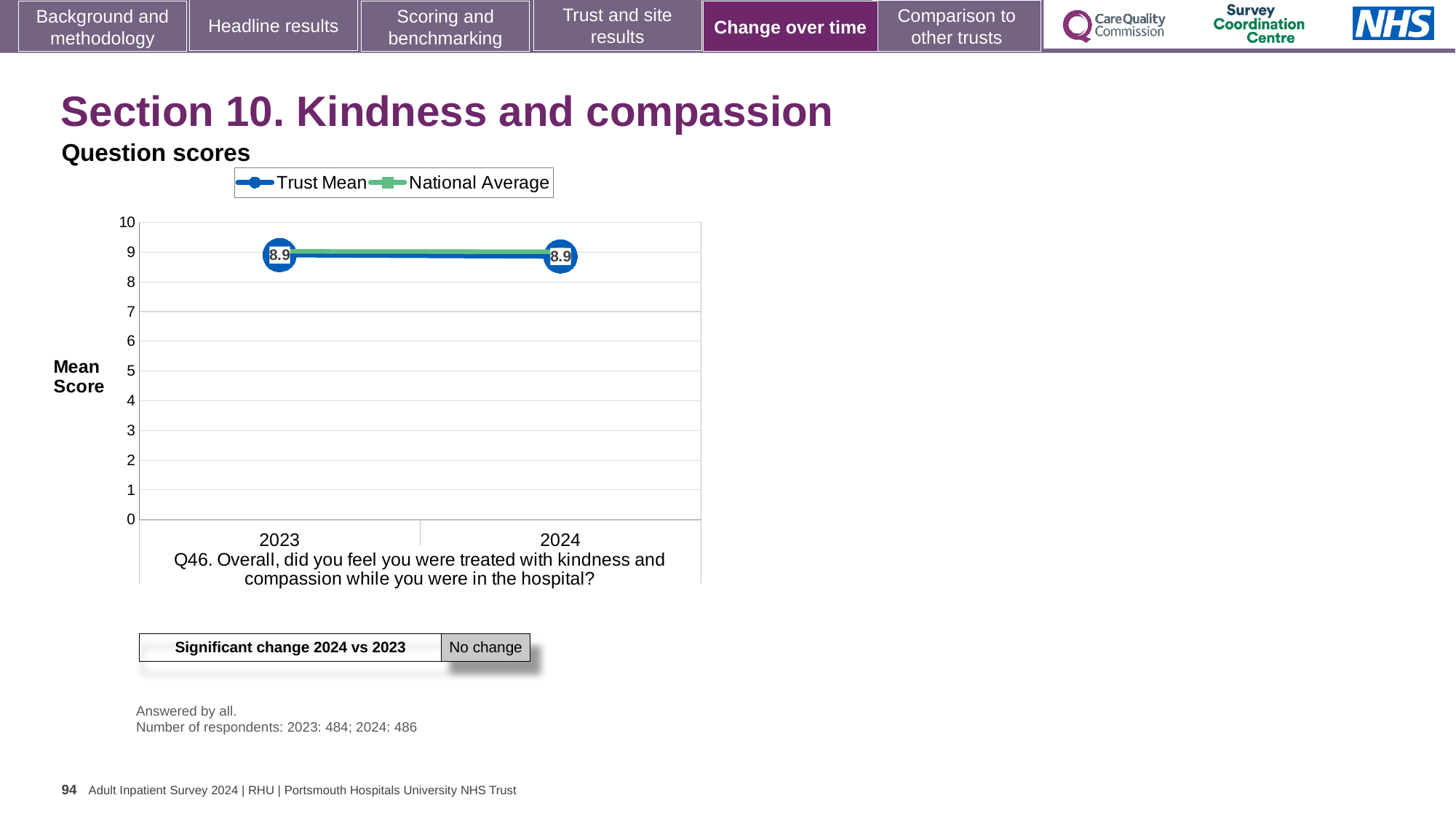
Does the Trust Mean rise, fall or stay the same from 2023 to 2024? stays the same What is the Trust Mean score for 2024 on the Q46 chart? 8.9 How many years are plotted on the x axis of the chart? 2 What is the Trust Mean score for 2023 on the Q46 chart? 8.9 What is the label of the y axis on the chart? Mean Score Is the National Average for 2023 greater or less than 8? greater Which series is shown in blue in the chart legend? Trust Mean How many series does the chart legend list? 2 What is the maximum value shown on the y axis of the chart? 10 What kind of chart is shown on the slide? line chart Is the Trust Mean for 2024 greater or less than 5? greater What is the difference between the Trust Mean scores for 2024 and 2023? 0